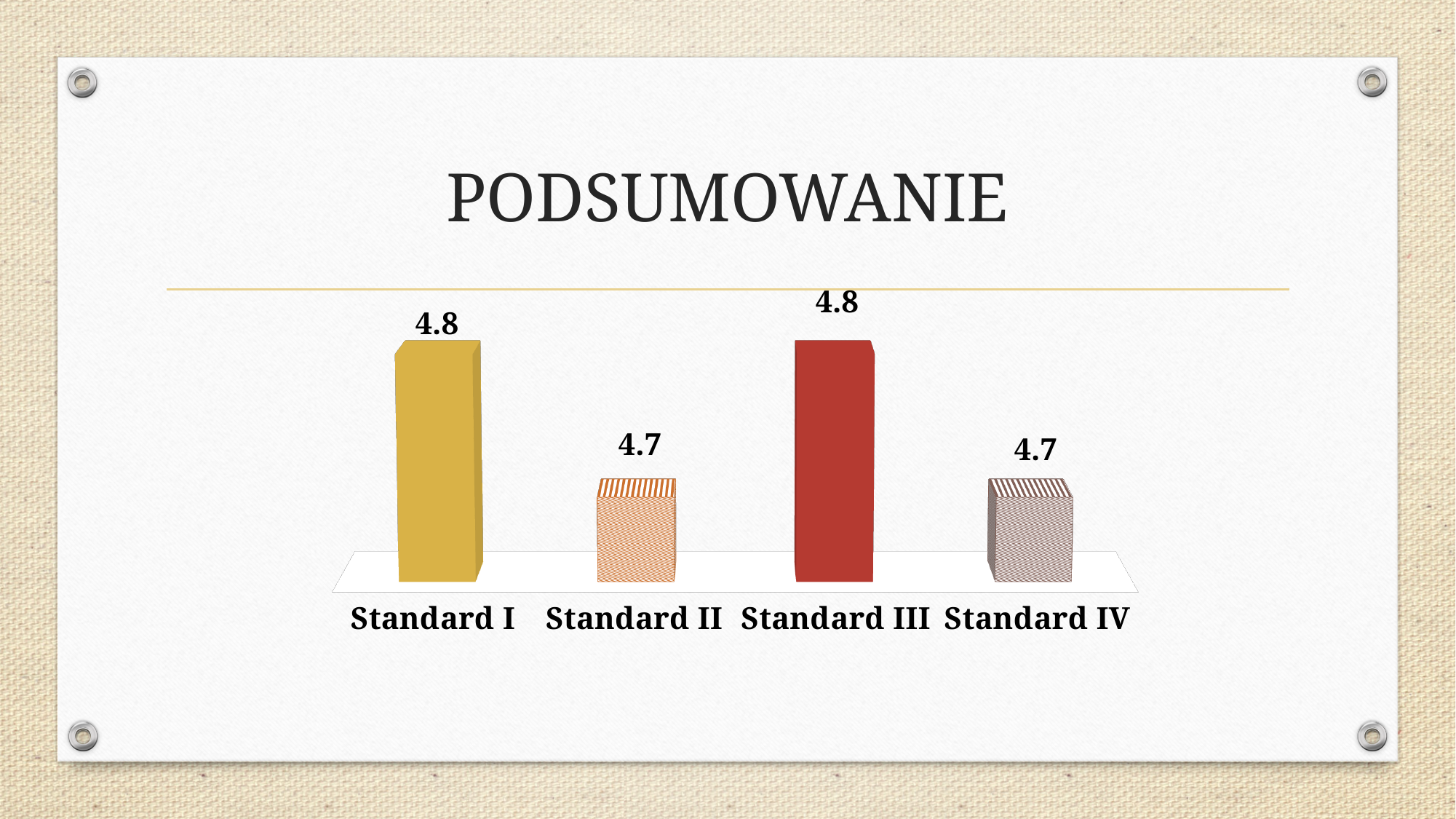
Which is larger, the value for Standard III or the value for Standard IV? Standard III What is the difference between the values for Standard III and Standard IV? 0.1 What is the difference between the values for Standard I and Standard II? 0.1 What kind of chart is shown on the slide? bar chart What colour is the bar for Standard III? red Which is larger, the value for Standard I or the value for Standard II? Standard I What is the value for Standard IV? 4.7 What is the value for Standard III? 4.8 What is the value for Standard I? 4.8 What is the value for Standard II? 4.7 What is the title of the slide containing the chart? PODSUMOWANIE How many categories are shown in the chart? 4